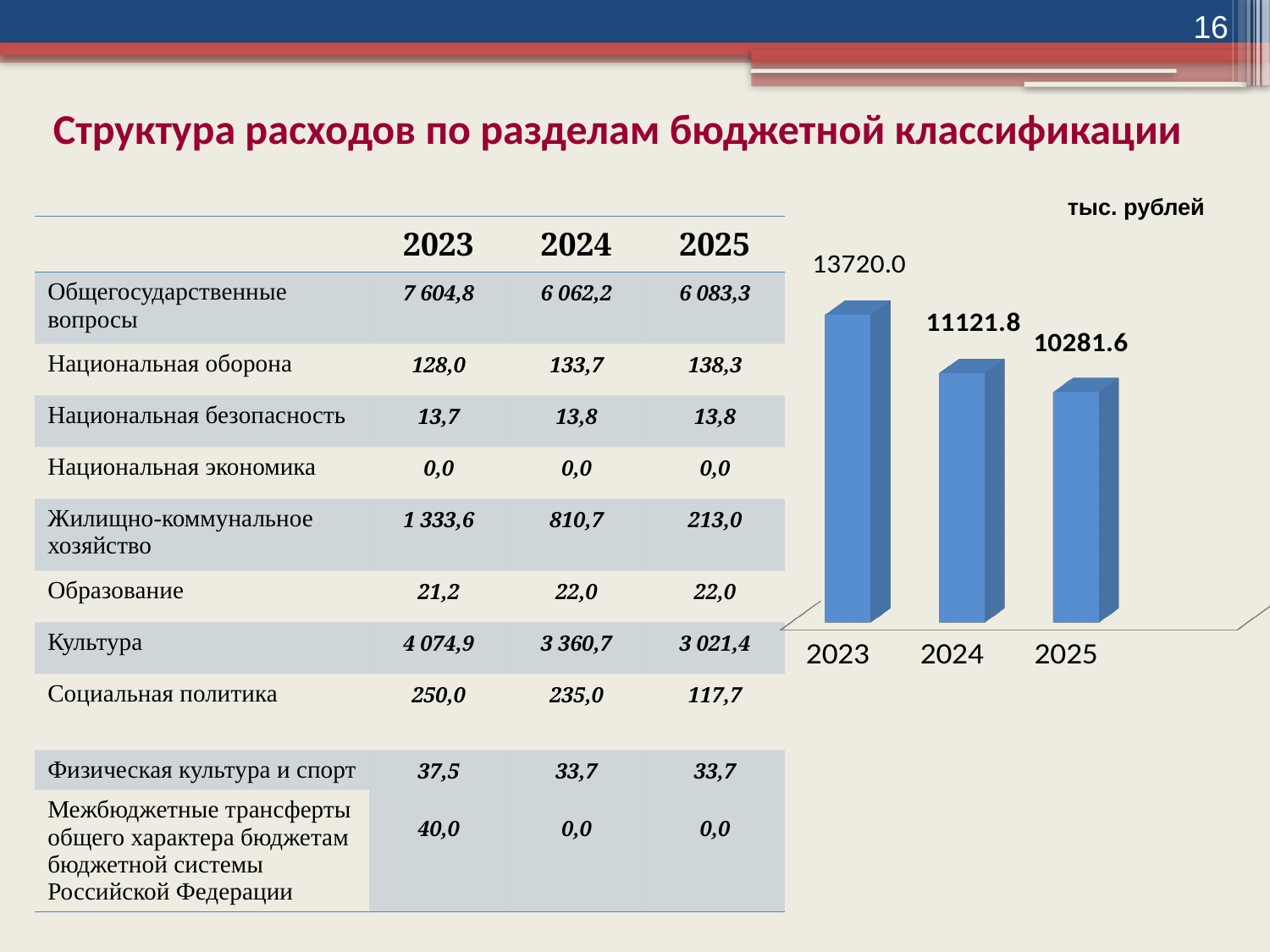
What is the difference between the 2024 and 2025 values in the chart? 840.2 What is the value of the bar for 2024 in the chart? 11121.8 How many bars does the chart show? 3 What type of chart is shown on the slide? bar chart What is the value of the bar for 2023 in the chart? 13720.0 What is the difference between the 2023 and 2024 values in the chart? 2598.2 What is the value of the bar for 2025 in the chart? 10281.6 Do the values in the chart rise or fall from 2023 to 2025? fall Which year has the highest bar in the chart? 2023 What unit is indicated above the chart? тыс. рублей Which year has the lowest bar in the chart? 2025 Which is larger in the chart, the value for 2024 or the value for 2025? 2024